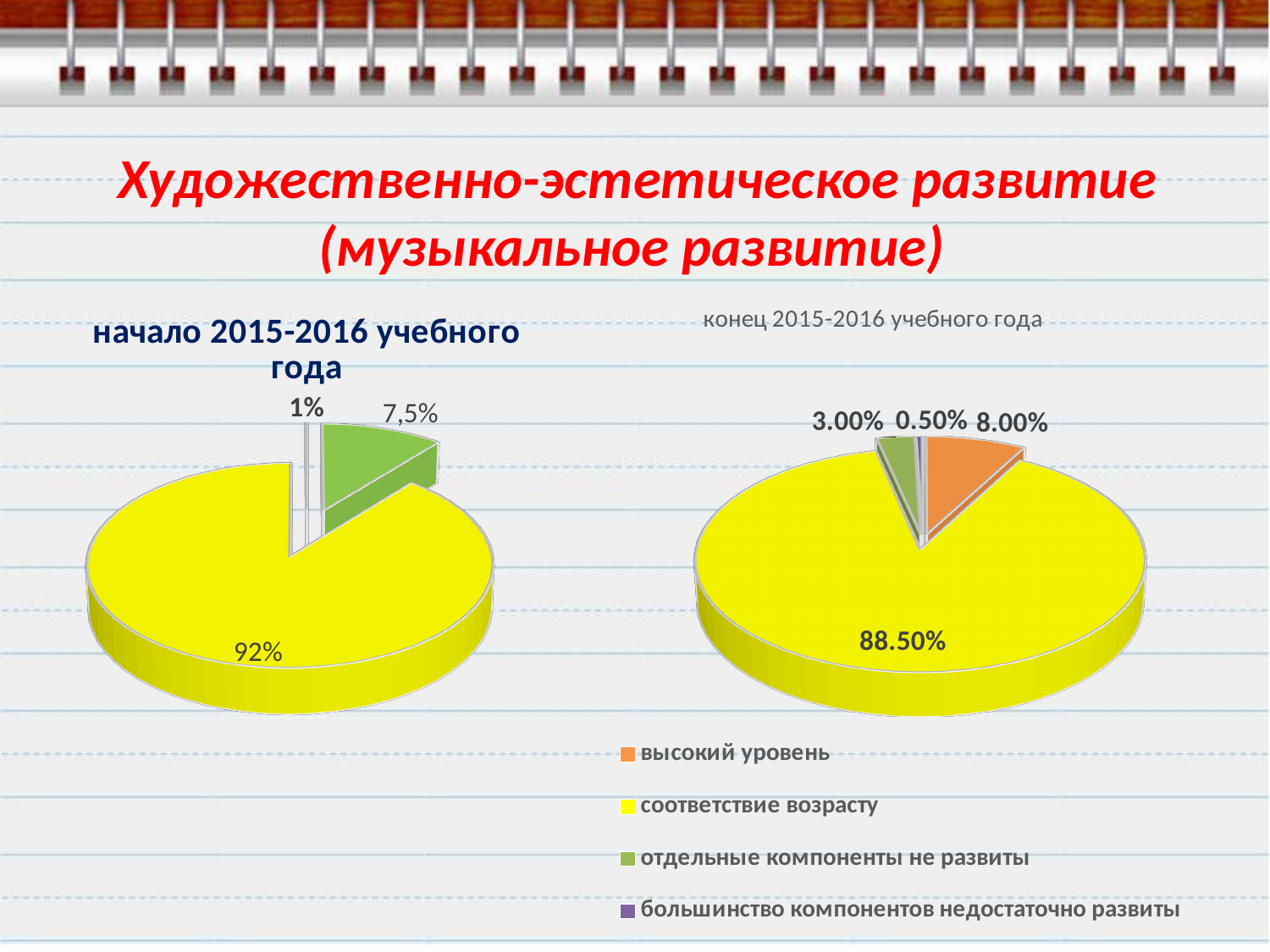
In the chart titled 'начало 2015-2016 учебного года', what share does the yellow slice (соответствие возрасту) have? 92% In the chart titled 'начало 2015-2016 учебного года', which category has the largest share? соответствие возрасту In the chart titled 'конец 2015-2016 учебного года', what share does the purple slice (большинство компонентов недостаточно развиты) have? 0.50% In the chart titled 'конец 2015-2016 учебного года', what share does the orange slice (высокий уровень) have? 8.00% In the chart titled 'конец 2015-2016 учебного года', which category has the smallest share? большинство компонентов недостаточно развиты In the chart titled 'начало 2015-2016 учебного года', what share does the green slice (отдельные компоненты не развиты) have? 7,5% How many labeled slices does the chart titled 'конец 2015-2016 учебного года' have? 4 Which is larger: the green slice in the 'начало 2015-2016 учебного года' chart or the green slice in the 'конец 2015-2016 учебного года' chart? начало 2015-2016 учебного года In the chart titled 'конец 2015-2016 учебного года', what share does the yellow slice (соответствие возрасту) have? 88.50% What kind of charts are shown on the slide? pie charts How many entries does the legend list? 4 In the chart titled 'конец 2015-2016 учебного года', what is the difference between the orange slice (8.00%) and the green slice (3.00%)? 5.00%